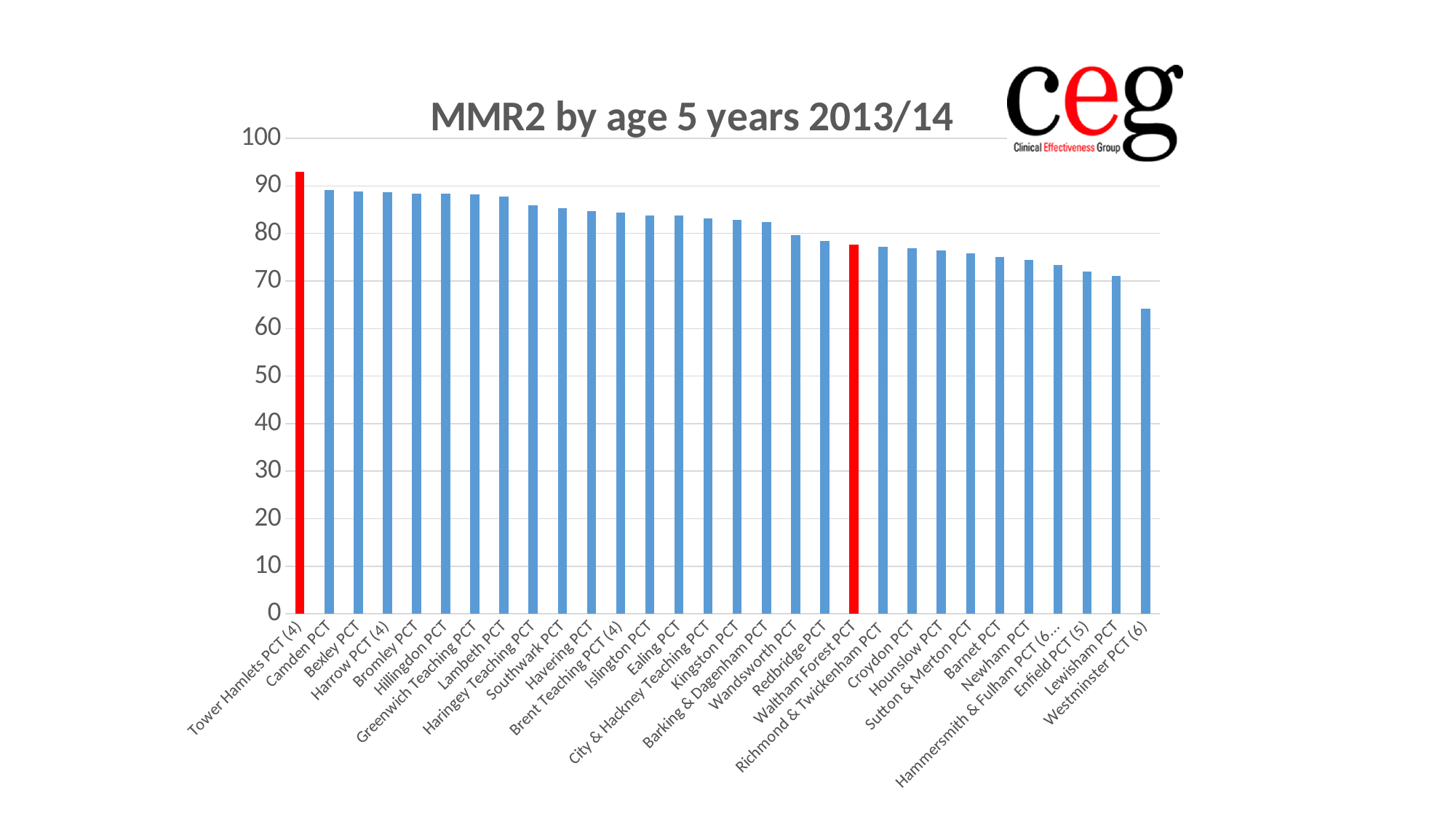
Is the value for Westminster PCT (6) greater or less than 70? less Is the value for Tower Hamlets PCT (4) greater or less than 90? greater What kind of chart is shown on the slide? Bar chart Which has the larger value, Tower Hamlets PCT (4) or Waltham Forest PCT? Tower Hamlets PCT (4) Which two PCTs are highlighted with red bars? Tower Hamlets PCT (4) and Waltham Forest PCT Which PCT has the lowest value in the chart? Westminster PCT (6) Do the values rise or fall moving from left to right along the x axis? Fall Which PCT has the highest value in the chart? Tower Hamlets PCT (4) Is the value for Camden PCT greater or less than 80? greater What is the title of the chart? MMR2 by age 5 years 2013/14 How many PCTs (bars) are shown in the chart? 30